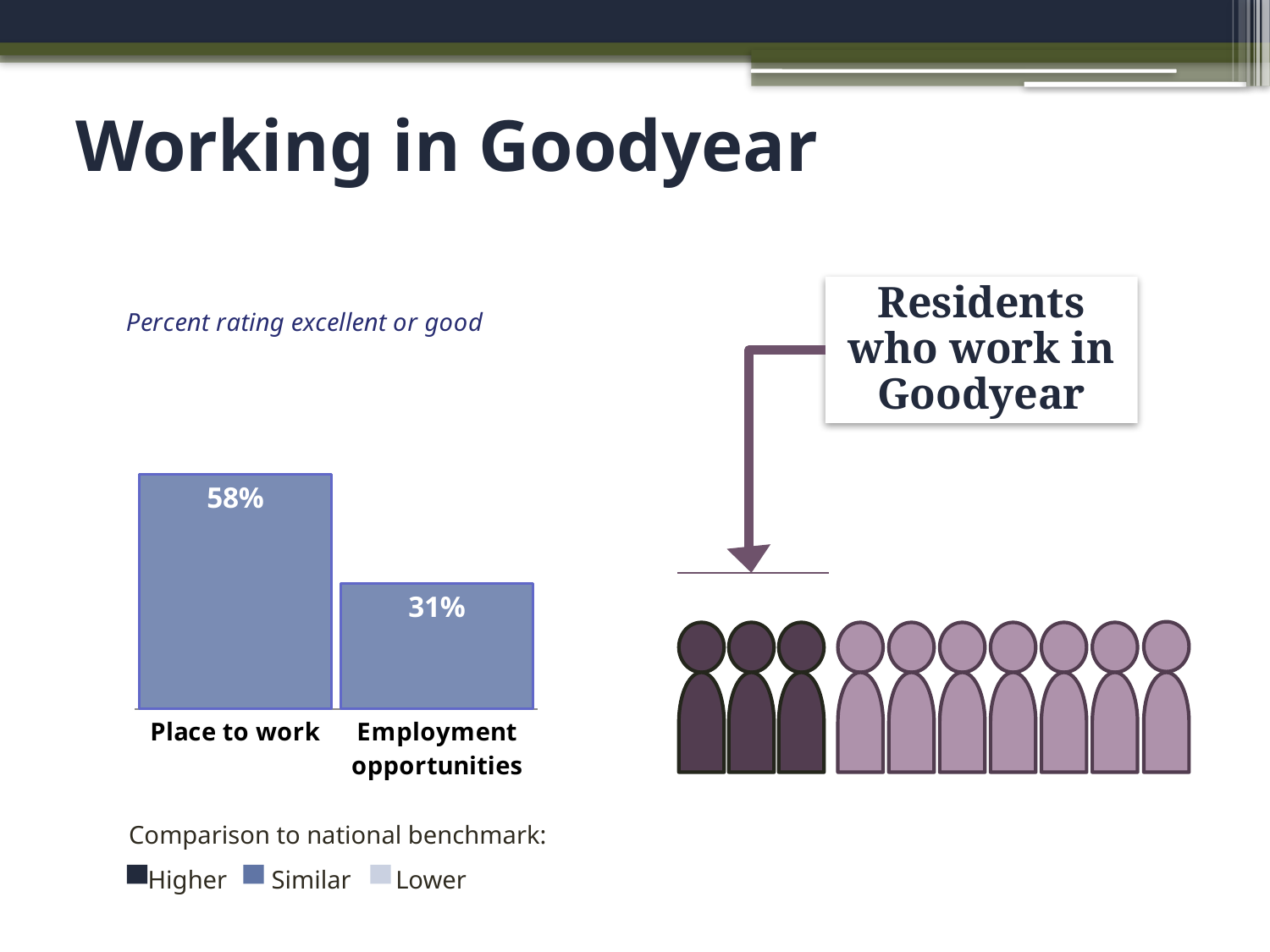
Is the value for Employment opportunities larger or smaller than the value for Place to work? smaller What percent rated employment opportunities excellent or good? 31% What percent of respondents rated Goodyear as a place to work excellent or good? 58% How many entries does the comparison-to-national-benchmark legend list? 3 What does the subtitle above the bar chart say the bars measure? Percent rating excellent or good What is the difference in percentage points between Place to work and Employment opportunities? 27 Which category has the higher rating, Place to work or Employment opportunities? Place to work According to the legend colour, how do both bars compare to the national benchmark? Similar In the pictograph of residents who work in Goodyear, how many of the 10 figures are shaded dark? 3 How many categories are shown in the bar chart? 2 Which category has the lowest percent rating excellent or good? Employment opportunities What kind of chart is used to show the percent rating excellent or good? bar chart